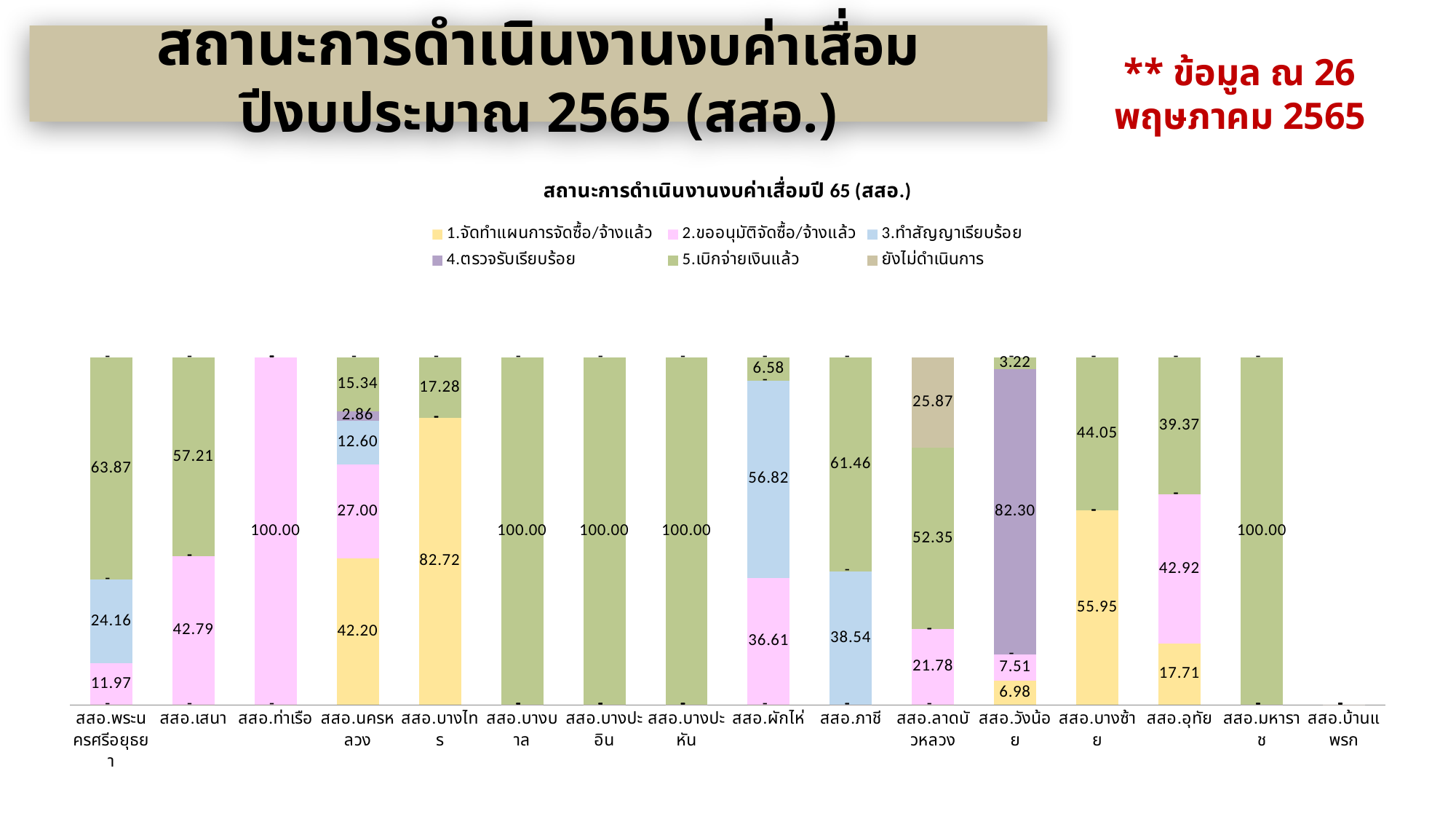
What is the value of ยังไม่ดำเนินการ for สสอ.ลาดบัวหลวง? 25.87 How many categories are shown on the x axis? 16 What is the value of 2.ขออนุมัติจัดซื้อ/จ้างแล้ว for สสอ.เสนา? 42.79 What is the value of 3.ทำสัญญาเรียบร้อย for สสอ.ผักไห่? 56.82 What kind of chart is shown on the slide? Stacked bar chart How many series does the legend list? 6 Which category has the highest value for 1.จัดทำแผนการจัดซื้อ/จ้างแล้ว? สสอ.บางไทร What is the difference between the 5.เบิกจ่ายเงินแล้ว value for สสอ.ภาชี and the 3.ทำสัญญาเรียบร้อย value for สสอ.ภาชี? 22.92 What is the value of 5.เบิกจ่ายเงินแล้ว for สสอ.พระนครศรีอยุธยา? 63.87 What is the value of 4.ตรวจรับเรียบร้อย for สสอ.วังน้อย? 82.30 Which is larger for สสอ.อุทัย: the 2.ขออนุมัติจัดซื้อ/จ้างแล้ว value or the 5.เบิกจ่ายเงินแล้ว value? 2.ขออนุมัติจัดซื้อ/จ้างแล้ว What is the value of 1.จัดทำแผนการจัดซื้อ/จ้างแล้ว for สสอ.บางไทร? 82.72